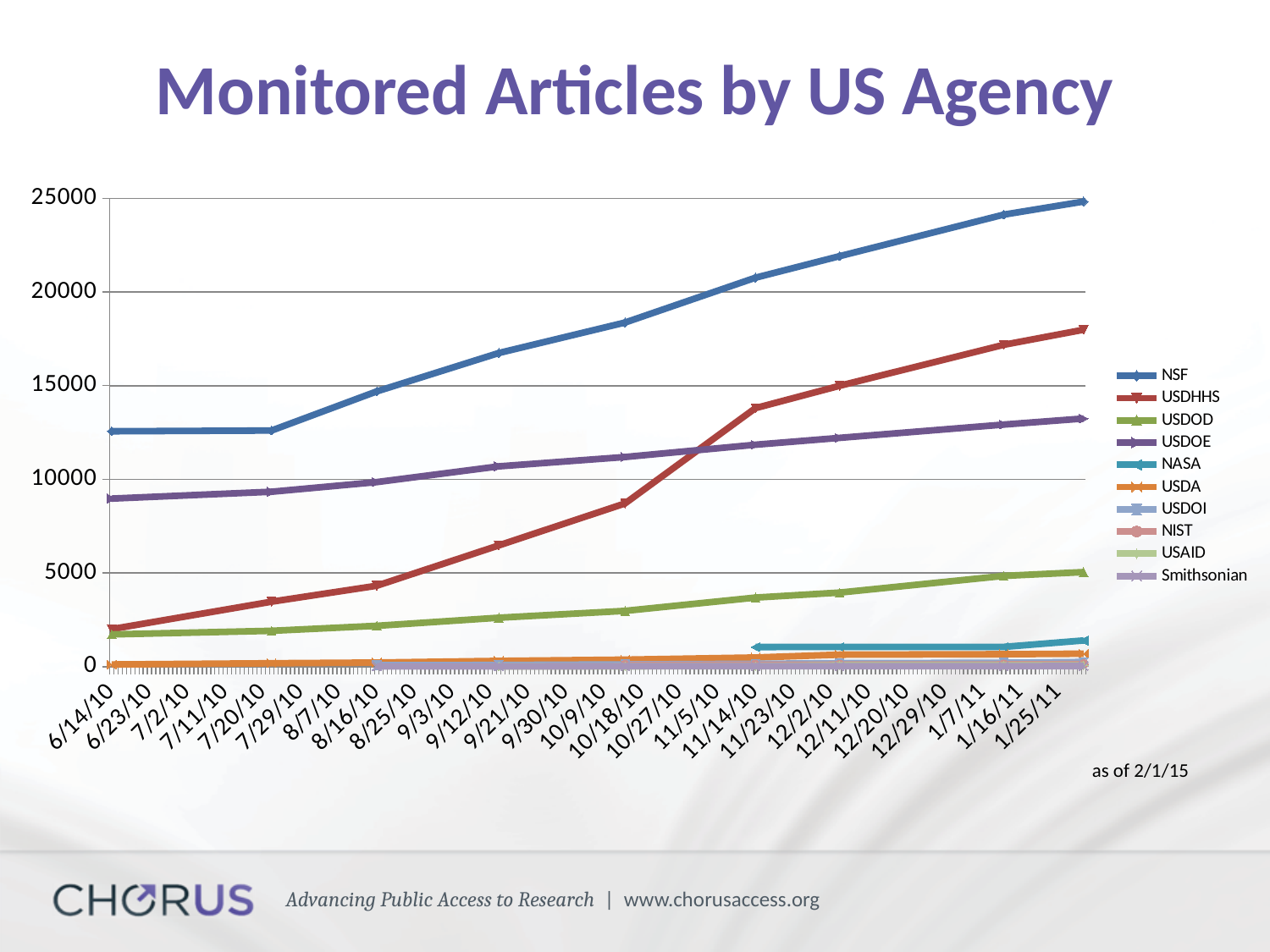
What is the title of the chart? Monitored Articles by US Agency Is the value for NSF at 1/25/11 greater or less than 20000? greater Is the value for USDHHS at 6/14/10 greater or less than 5000? less What kind of chart is shown on the slide? line chart How many series does the legend list? 10 At 1/25/11, which is larger: USDHHS or USDOE? USDHHS How many date labels are shown on the x axis? 26 Is the value for USDOD at 1/25/11 greater or less than 10000? less At 6/14/10, which is larger: USDOE or USDHHS? USDOE Which agency has the highest number of monitored articles at 1/25/11? NSF Does the NSF line rise or fall from 6/14/10 to 1/25/11? rise As of what date is the chart data reported? 2/1/15